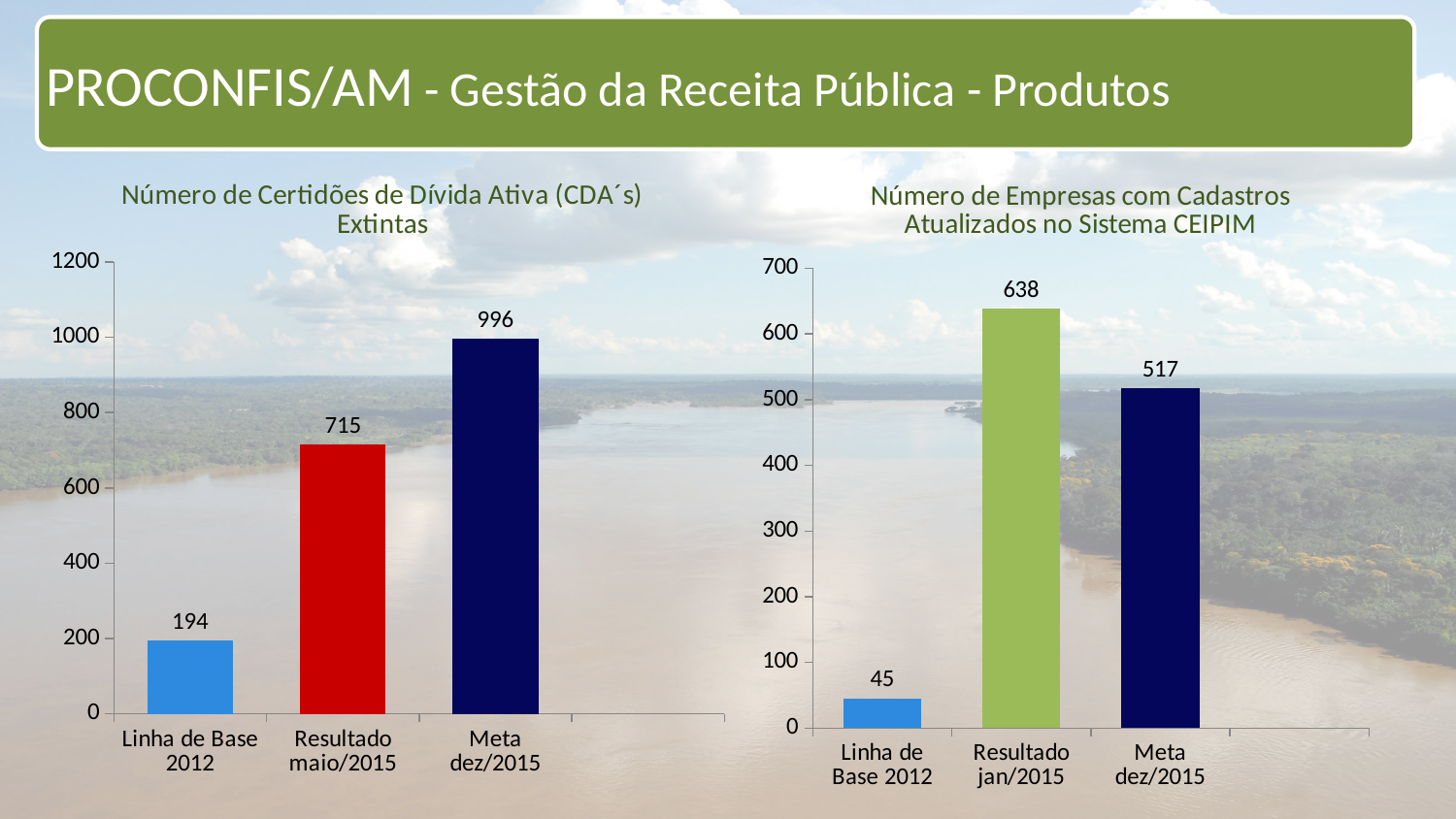
In the right chart (Número de Empresas com Cadastros Atualizados no Sistema CEIPIM), which is larger: Resultado jan/2015 or Meta dez/2015? Resultado jan/2015 In the right chart (Número de Empresas com Cadastros Atualizados no Sistema CEIPIM), what is the difference between Resultado jan/2015 and Linha de Base 2012? 593 In the right chart (Número de Empresas com Cadastros Atualizados no Sistema CEIPIM), which category has the lowest value? Linha de Base 2012 In the left chart (Número de Certidões de Dívida Ativa (CDA´s) Extintas), which category has the highest value? Meta dez/2015 In the right chart (Número de Empresas com Cadastros Atualizados no Sistema CEIPIM), what is the value for Resultado jan/2015? 638 What kind of chart is the right chart (Número de Empresas com Cadastros Atualizados no Sistema CEIPIM)? Bar chart In the left chart (Número de Certidões de Dívida Ativa (CDA´s) Extintas), do the values rise or fall from left to right? Rise In the left chart (Número de Certidões de Dívida Ativa (CDA´s) Extintas), what is the difference between Meta dez/2015 and Resultado maio/2015? 281 In the left chart (Número de Certidões de Dívida Ativa (CDA´s) Extintas), what is the value for Linha de Base 2012? 194 In the left chart (Número de Certidões de Dívida Ativa (CDA´s) Extintas), how many bars are plotted? 3 In the right chart (Número de Empresas com Cadastros Atualizados no Sistema CEIPIM), what is the value for Meta dez/2015? 517 In the left chart (Número de Certidões de Dívida Ativa (CDA´s) Extintas), what is the value for Resultado maio/2015? 715